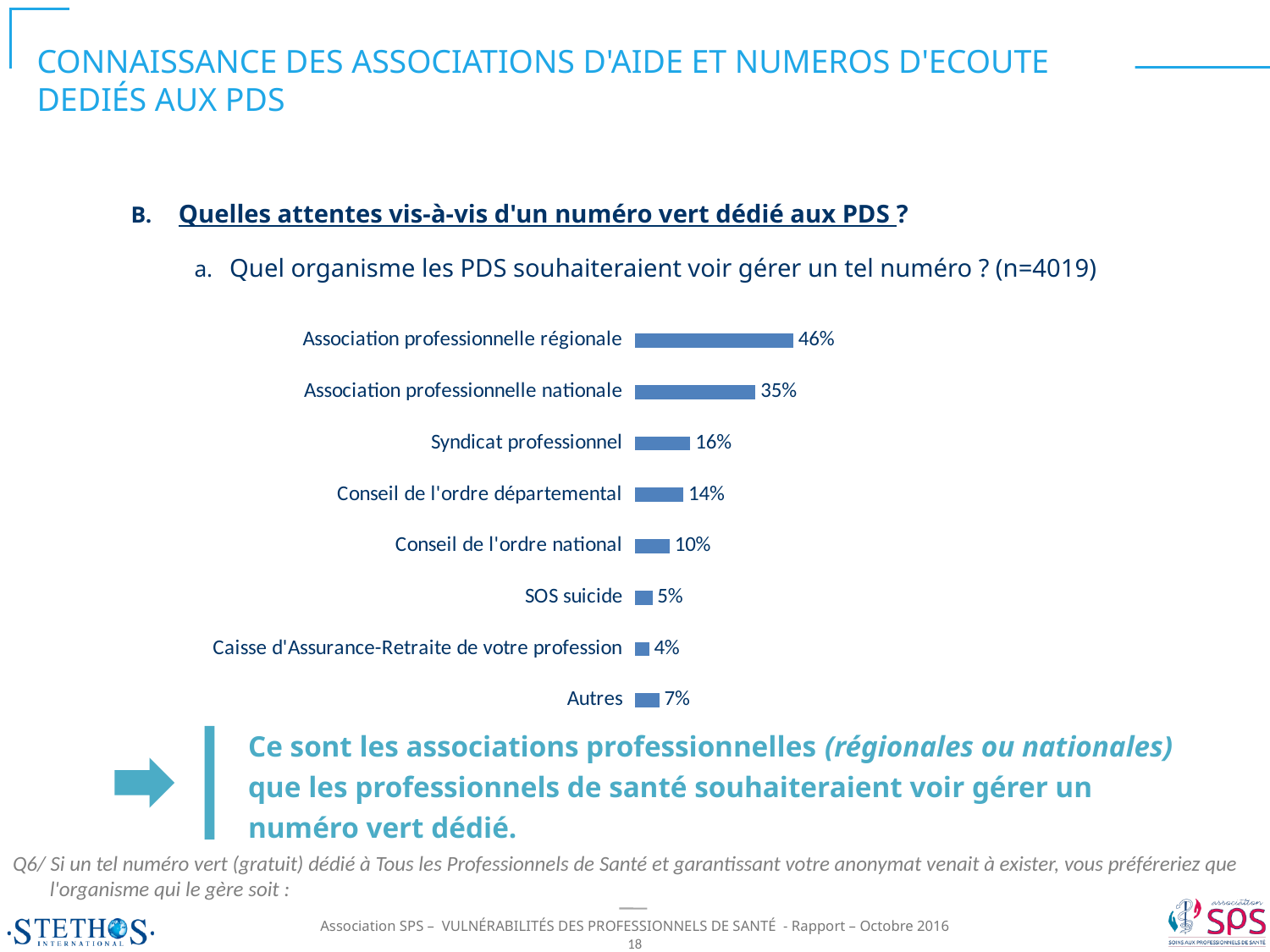
What is the difference between 'Conseil de l'ordre départemental' and 'Conseil de l'ordre national'? 4% What percentage of respondents chose 'Association professionnelle régionale'? 46% Which is larger: 'Syndicat professionnel' or 'Conseil de l'ordre départemental'? Syndicat professionnel What is the value shown for 'Syndicat professionnel'? 16% What type of chart is shown on the slide? Bar chart Which category has the highest value? Association professionnelle régionale What is the sample size (n) indicated for this question? 4019 How many categories are shown in the chart? 8 What percentage is shown for 'Caisse d'Assurance-Retraite de votre profession'? 4% Which category has the lowest value? Caisse d'Assurance-Retraite de votre profession What is the difference between 'Association professionnelle régionale' and 'Association professionnelle nationale'? 11% Which is larger: 'SOS suicide' or 'Autres'? Autres